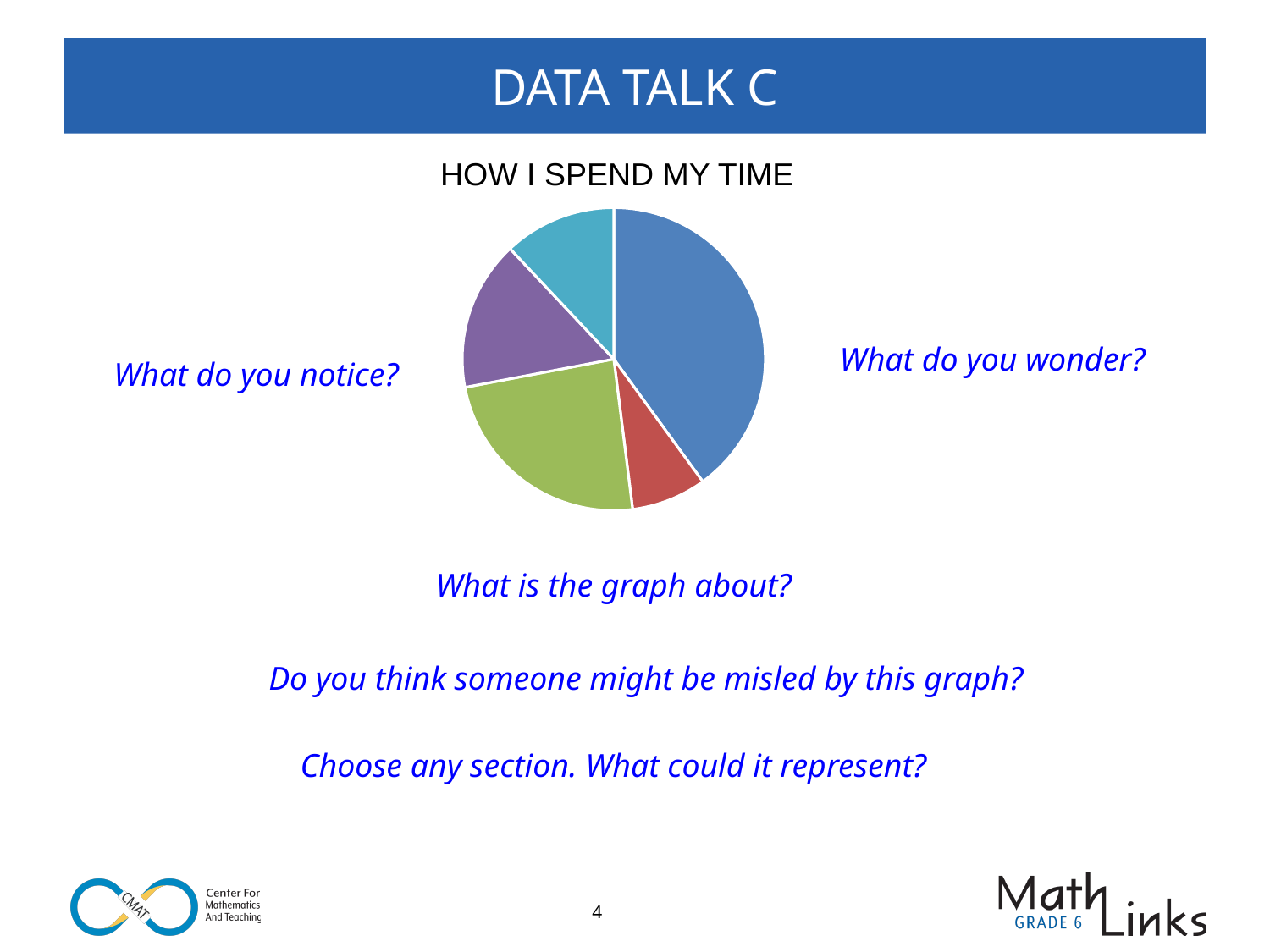
Which is larger in the pie chart, the teal slice or the red slice? teal Which is larger in the pie chart, the green slice or the purple slice? green How many slices does the pie chart have? 5 Which colour slice is the smallest in the pie chart? red Which is larger in the pie chart, the green slice or the red slice? green What is the title of the pie chart? HOW I SPEND MY TIME Does the pie chart show a legend identifying the slices? no Which colour slice is the largest in the pie chart? blue What kind of chart is shown on the slide? pie chart